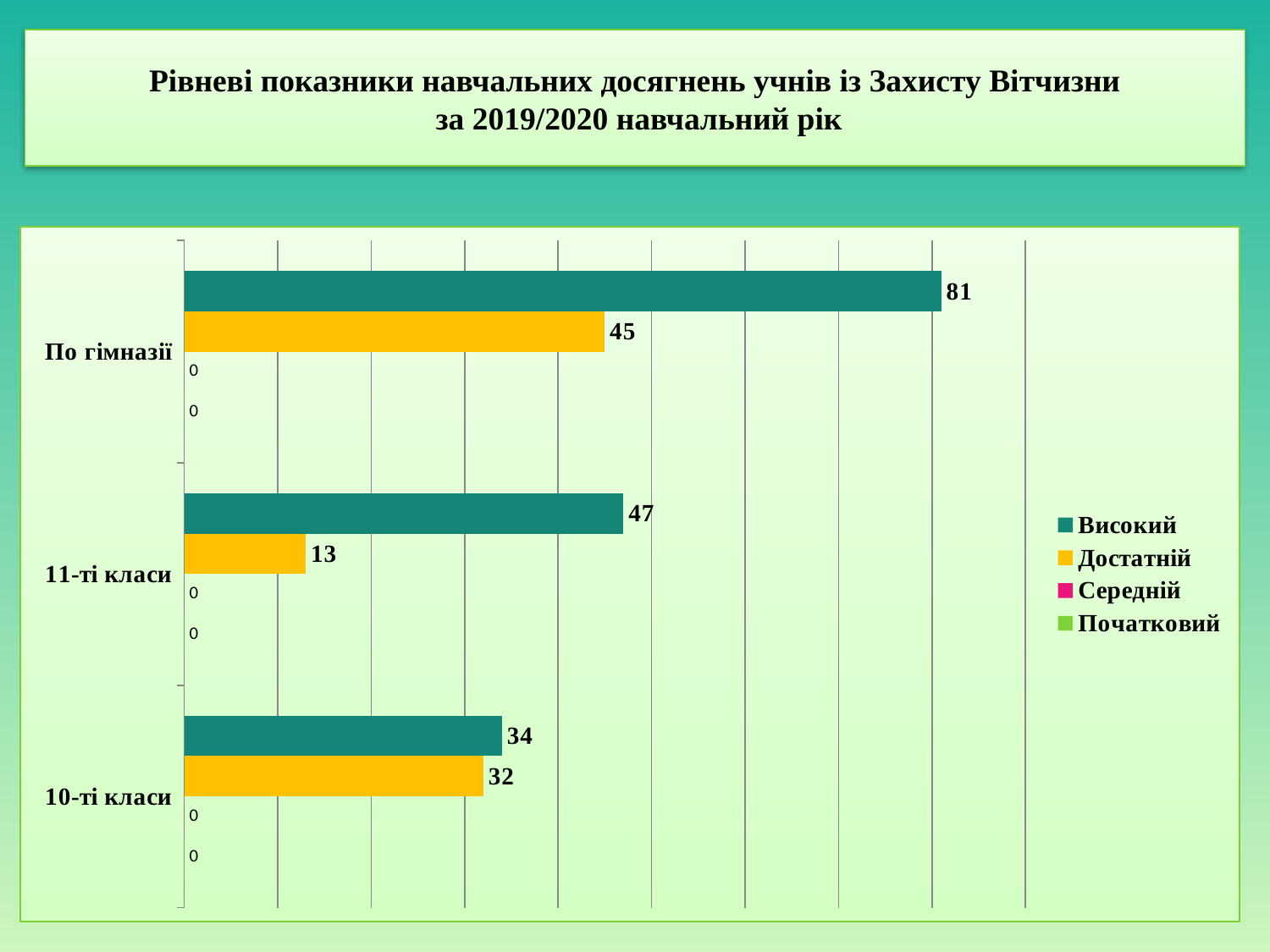
Which is larger for 10-ті класи: Високий or Достатній? Високий What is the difference between the Високий and Достатній values for 11-ті класи? 34 How many categories are shown on the chart? 3 What is the difference between the Високий values for По гімназії and 10-ті класи? 47 Which category has the lowest Достатній value? 11-ті класи What kind of chart is shown on the slide? Bar chart How many series does the legend list? 4 What is the value of Достатній for 10-ті класи? 32 What is the value of Достатній for 11-ті класи? 13 What is the value of Середній for 11-ті класи? 0 Which category has the highest Високий value? По гімназії What is the value of Високий for По гімназії? 81